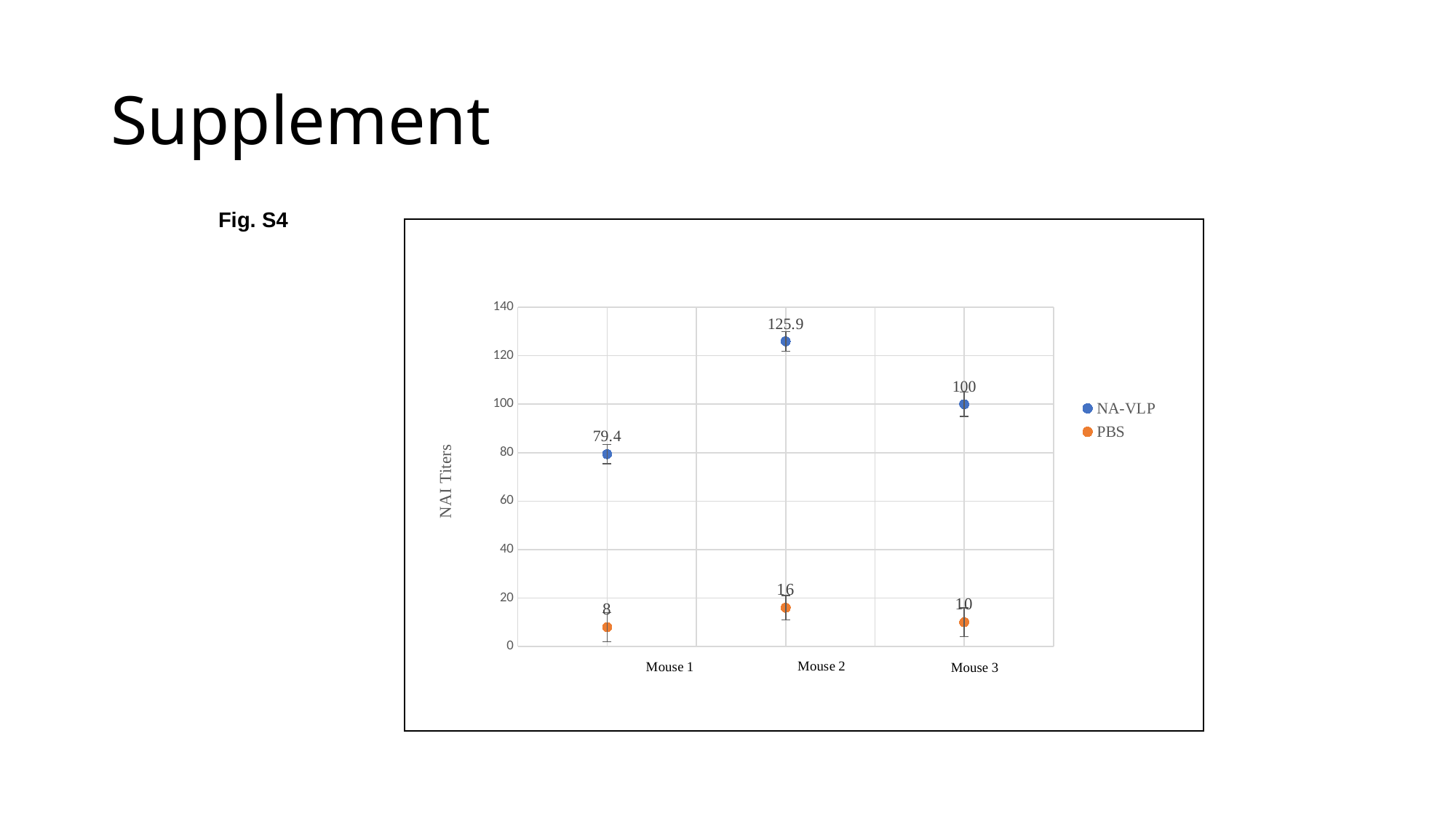
How many mice (categories) are shown on the x axis? 3 What is the label of the y axis? NAI Titers What is the NA-VLP value for Mouse 2? 125.9 Which mouse has the lowest PBS value? Mouse 1 What is the NA-VLP value for Mouse 3? 100 What is the difference between the NA-VLP values for Mouse 2 and Mouse 1? 46.5 What is the difference between the NA-VLP and PBS values for Mouse 3? 90 Is the NA-VLP value for Mouse 1 greater or less than 60? greater Which is larger, the PBS value for Mouse 2 or the PBS value for Mouse 3? Mouse 2 Which mouse has the highest NA-VLP value? Mouse 2 How many series does the legend list? 2 What is the PBS value for Mouse 1? 8